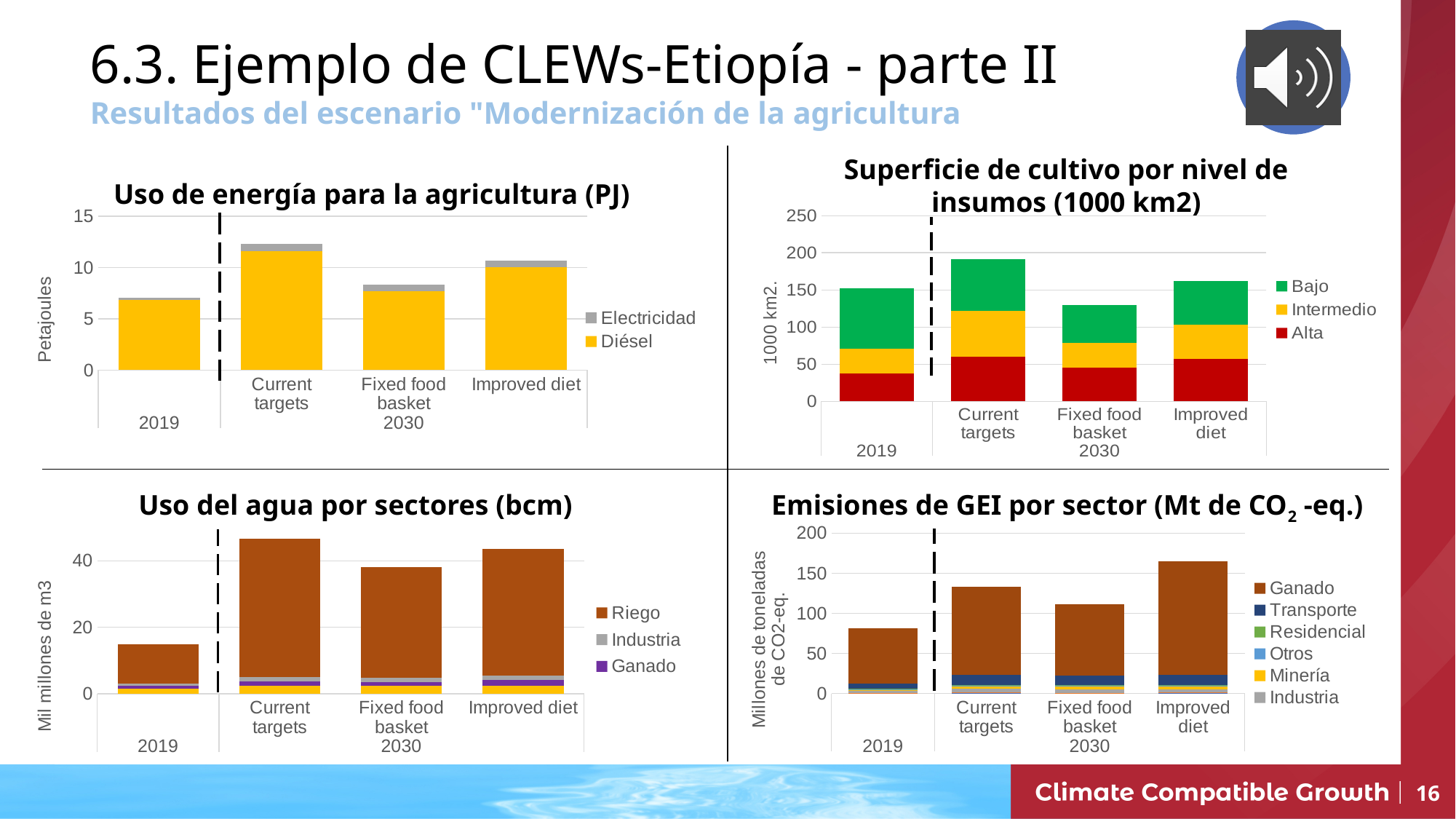
In the chart 'Emisiones de GEI por sector', which category has the highest total emissions? Improved diet In the chart 'Emisiones de GEI por sector', how many series does the legend list? 6 In the chart 'Superficie de cultivo por nivel de insumos (1000 km2)', is the total value for Current targets greater or less than 150? greater In the chart 'Uso del agua por sectores (bcm)', which is larger, the total for Current targets or the total for Improved diet? Current targets In the chart 'Superficie de cultivo por nivel de insumos (1000 km2)', which category has the lowest total cultivated area? Fixed food basket In the chart 'Superficie de cultivo por nivel de insumos (1000 km2)', which series is shown in red? Alta In the chart 'Uso del agua por sectores (bcm)', is the total value for Fixed food basket greater or less than 40? less In the chart 'Uso de energía para la agricultura (PJ)', how many series does the legend list? 2 In the chart 'Uso de energía para la agricultura (PJ)', is the total value for Current targets greater or less than 10? greater What kind of chart is 'Emisiones de GEI por sector'? Stacked bar chart In the chart 'Uso de energía para la agricultura (PJ)', which category has the highest total energy use? Current targets In the chart 'Uso del agua por sectores (bcm)', which category has the lowest total water use? 2019